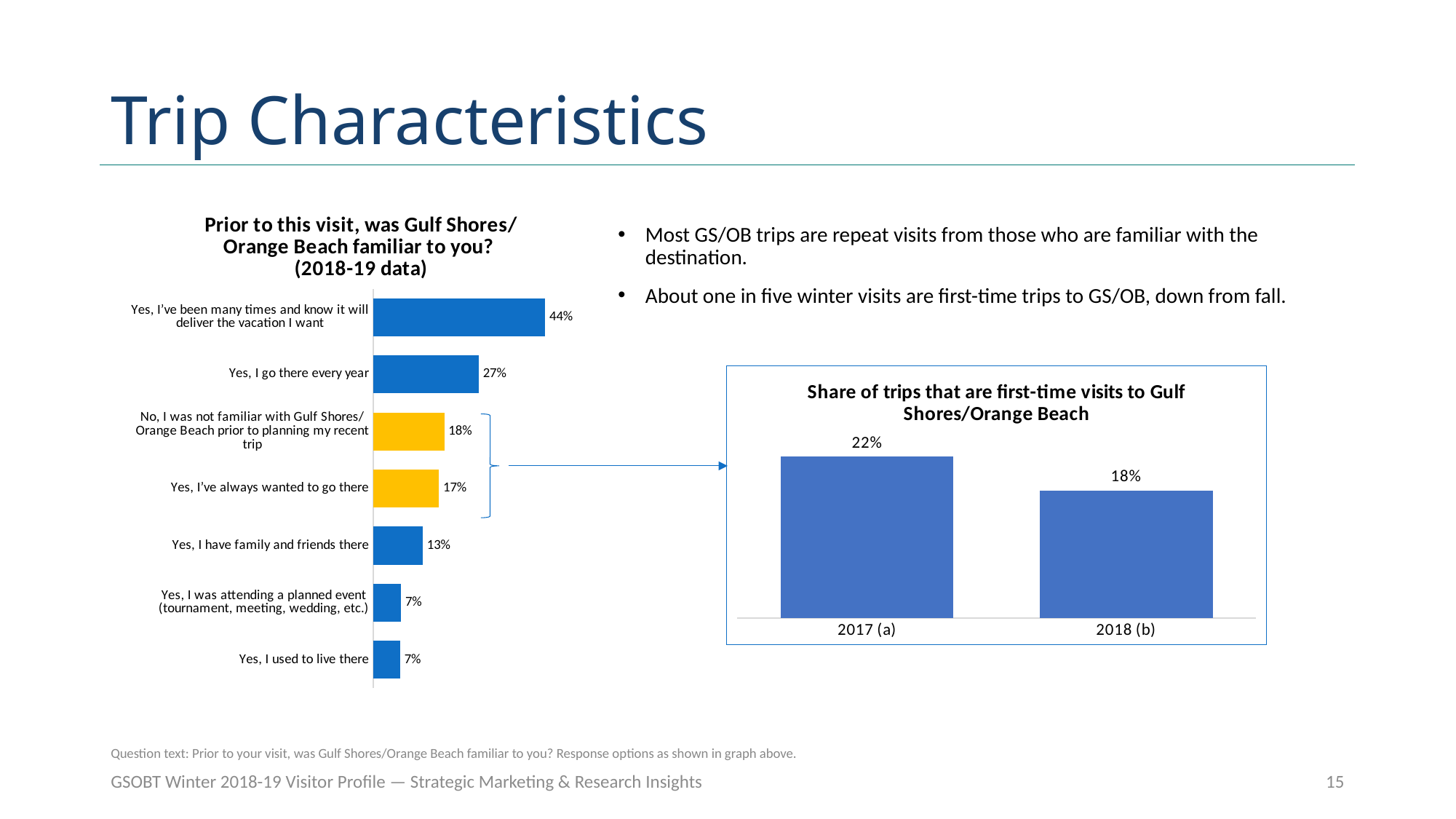
What kind of chart is the 'Prior to this visit, was Gulf Shores/Orange Beach familiar to you?' chart? Bar chart In the 'Share of trips that are first-time visits to Gulf Shores/Orange Beach' chart, what is the value for 2017 (a)? 22% In the 'Prior to this visit, was Gulf Shores/Orange Beach familiar to you?' chart, what is the value for 'Yes, I go there every year'? 27% In the 'Prior to this visit, was Gulf Shores/Orange Beach familiar to you?' chart, which two bars are coloured yellow? No, I was not familiar with Gulf Shores/Orange Beach prior to planning my recent trip; Yes, I've always wanted to go there In the 'Prior to this visit, was Gulf Shores/Orange Beach familiar to you?' chart, which response has the highest value? Yes, I've been many times and know it will deliver the vacation I want In the 'Share of trips that are first-time visits to Gulf Shores/Orange Beach' chart, what is the difference between 2017 (a) and 2018 (b)? 4 percentage points In the 'Prior to this visit, was Gulf Shores/Orange Beach familiar to you?' chart, what is the difference between 'Yes, I've been many times and know it will deliver the vacation I want' and 'Yes, I go there every year'? 17 percentage points In the 'Share of trips that are first-time visits to Gulf Shores/Orange Beach' chart, do the values rise or fall from 2017 (a) to 2018 (b)? Fall In the 'Prior to this visit, was Gulf Shores/Orange Beach familiar to you?' chart, what is the value for 'Yes, I have family and friends there'? 13% How many response categories are shown in the 'Prior to this visit, was Gulf Shores/Orange Beach familiar to you?' chart? 7 In the 'Share of trips that are first-time visits to Gulf Shores/Orange Beach' chart, what is the value for 2018 (b)? 18% In the 'Prior to this visit, was Gulf Shores/Orange Beach familiar to you?' chart, which is larger: 'No, I was not familiar with Gulf Shores/Orange Beach prior to planning my recent trip' or 'Yes, I've always wanted to go there'? No, I was not familiar with Gulf Shores/Orange Beach prior to planning my recent trip